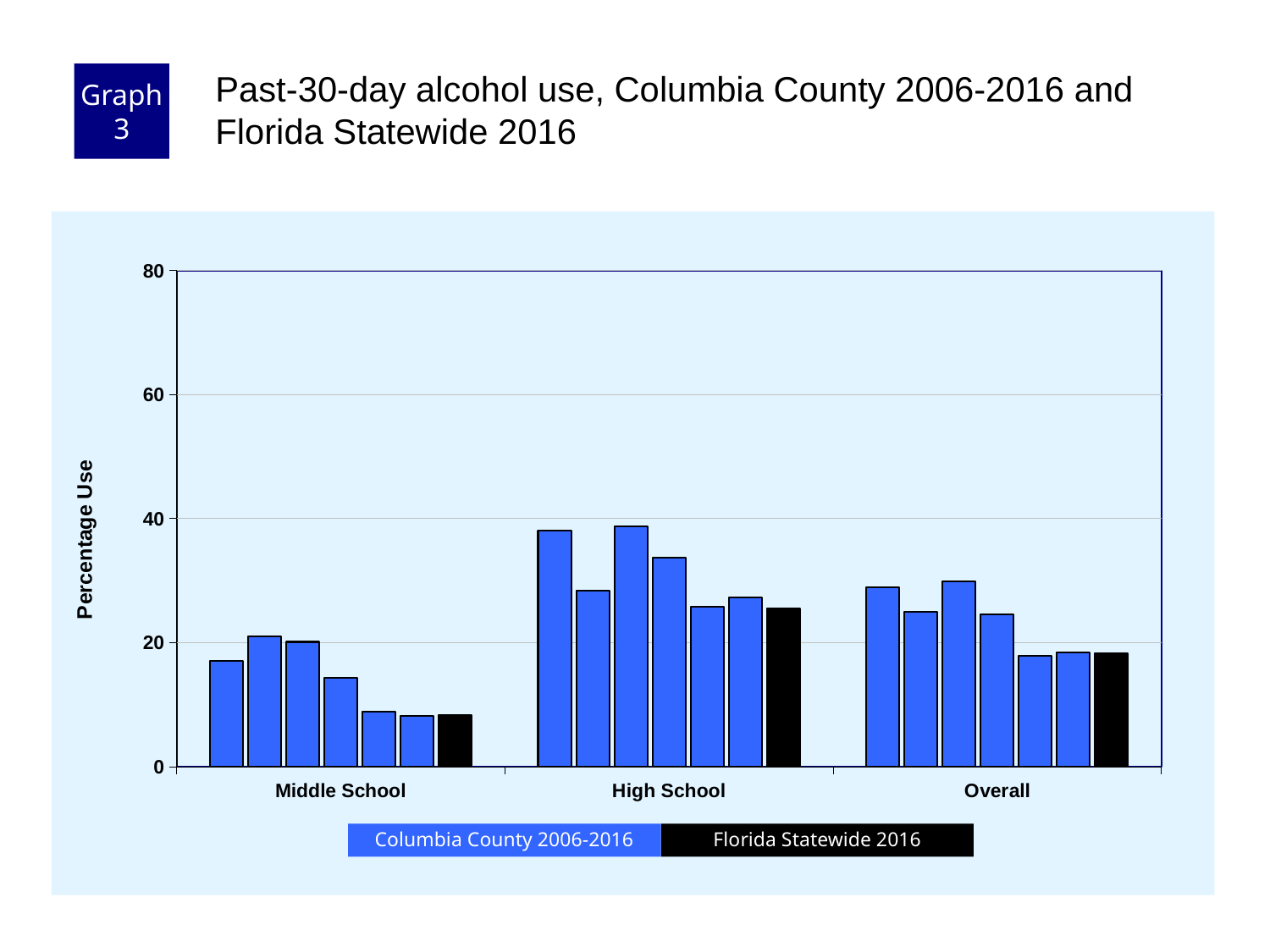
Which category has the lowest Florida Statewide 2016 value? Middle School How many categories are shown along the x axis? 3 What colour are the Florida Statewide 2016 bars? black What is the label on the vertical axis? Percentage Use Which category has the highest Florida Statewide 2016 value? High School What kind of chart is shown on the slide? bar chart Which is larger, the Florida Statewide 2016 value for High School or for Overall? High School Is the Florida Statewide 2016 value for High School greater or less than 20? greater Is the Florida Statewide 2016 value for Overall greater or less than 20? less Which category contains the tallest bar in the chart? High School Is the Florida Statewide 2016 value for Middle School greater or less than 20? less How many series does the legend list? 2